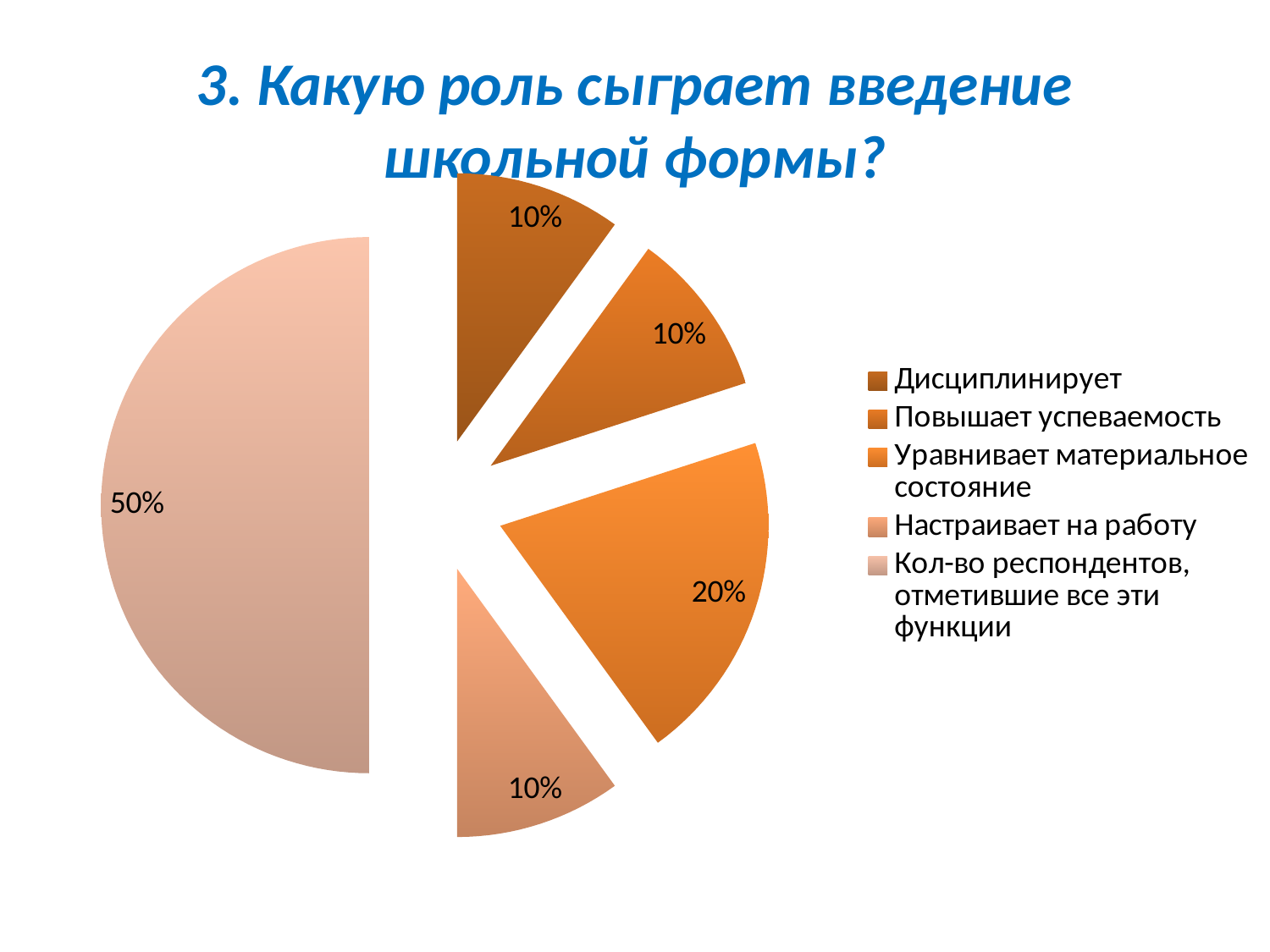
Which is larger: the share for "Уравнивает материальное состояние" or the share for "Дисциплинирует"? Уравнивает материальное состояние Which category has the largest slice of the pie? Кол-во респондентов, отметившие все эти функции How many slices does the pie chart have? 5 What is the value for "Дисциплинирует"? 10% What share of the pie is labelled "Уравнивает материальное состояние"? 20% What is the value for "Повышает успеваемость"? 10% How many entries does the legend list? 5 What share of the pie is labelled "Кол-во респондентов, отметившие все эти функции"? 50% What is the value for "Настраивает на работу"? 10% What is the title of the chart on the slide? 3. Какую роль сыграет введение школьной формы? What is the difference between the share for "Кол-во респондентов, отметившие все эти функции" and the share for "Уравнивает материальное состояние"? 30% What kind of chart is shown on the slide? pie chart